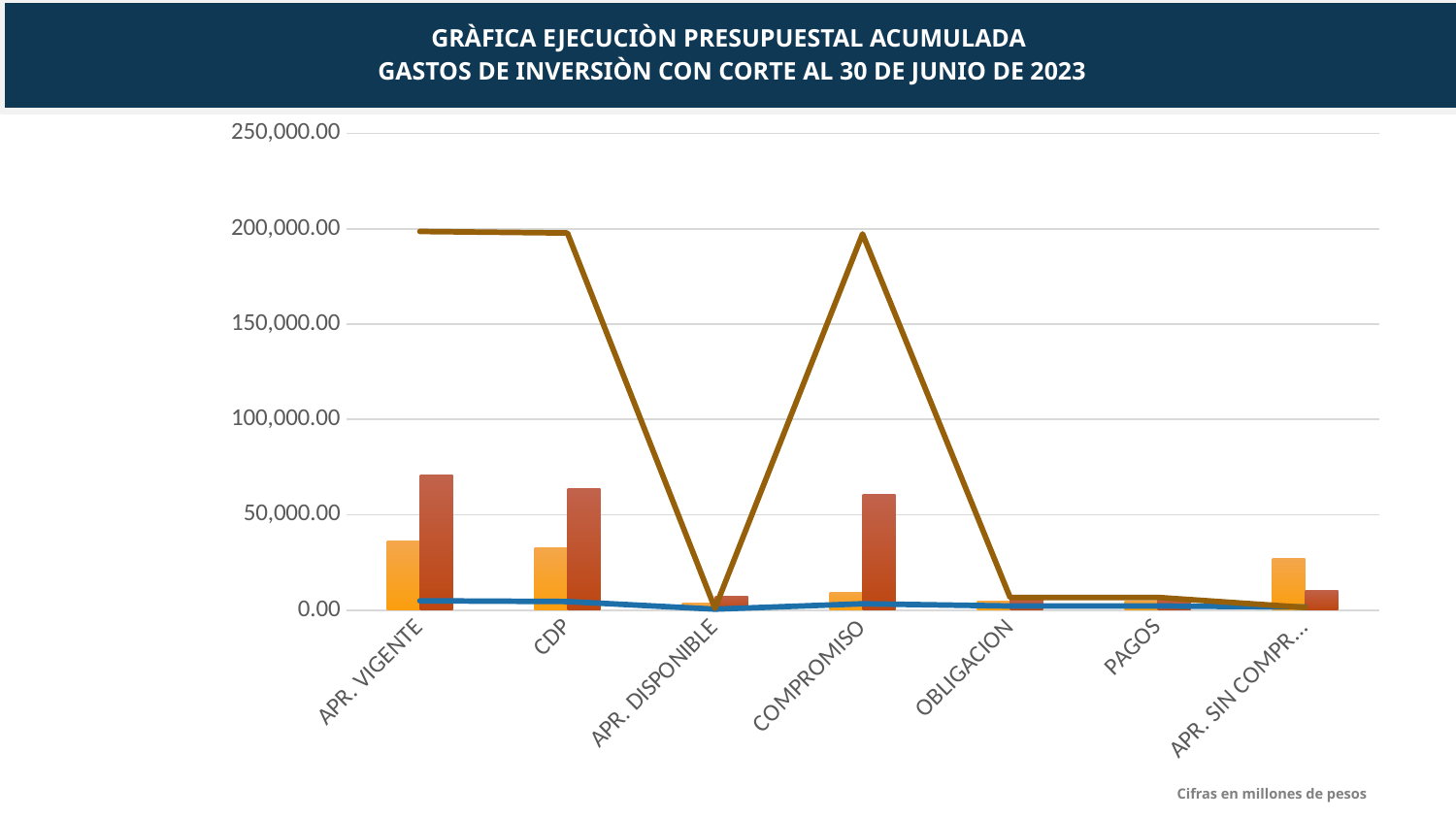
For the last category (APR. SIN COMPR...), which is larger: the orange bar or the red bar? The orange bar For which category is the red bar the highest? APR. VIGENTE Is the value of the brown line for APR. VIGENTE greater or less than 150,000.00? greater According to the note on the slide, in what units are the figures expressed? Millones de pesos Is the value of the orange bar for APR. VIGENTE greater or less than 50,000.00? less For APR. VIGENTE, which is larger: the orange bar or the red bar? The red bar How many categories are shown along the x axis? 7 Is the value of the brown line for APR. DISPONIBLE greater or less than 50,000.00? less Does the brown line rise or fall from CDP to APR. DISPONIBLE? Fall What kind of chart is shown on the slide? A combination chart with bars and lines